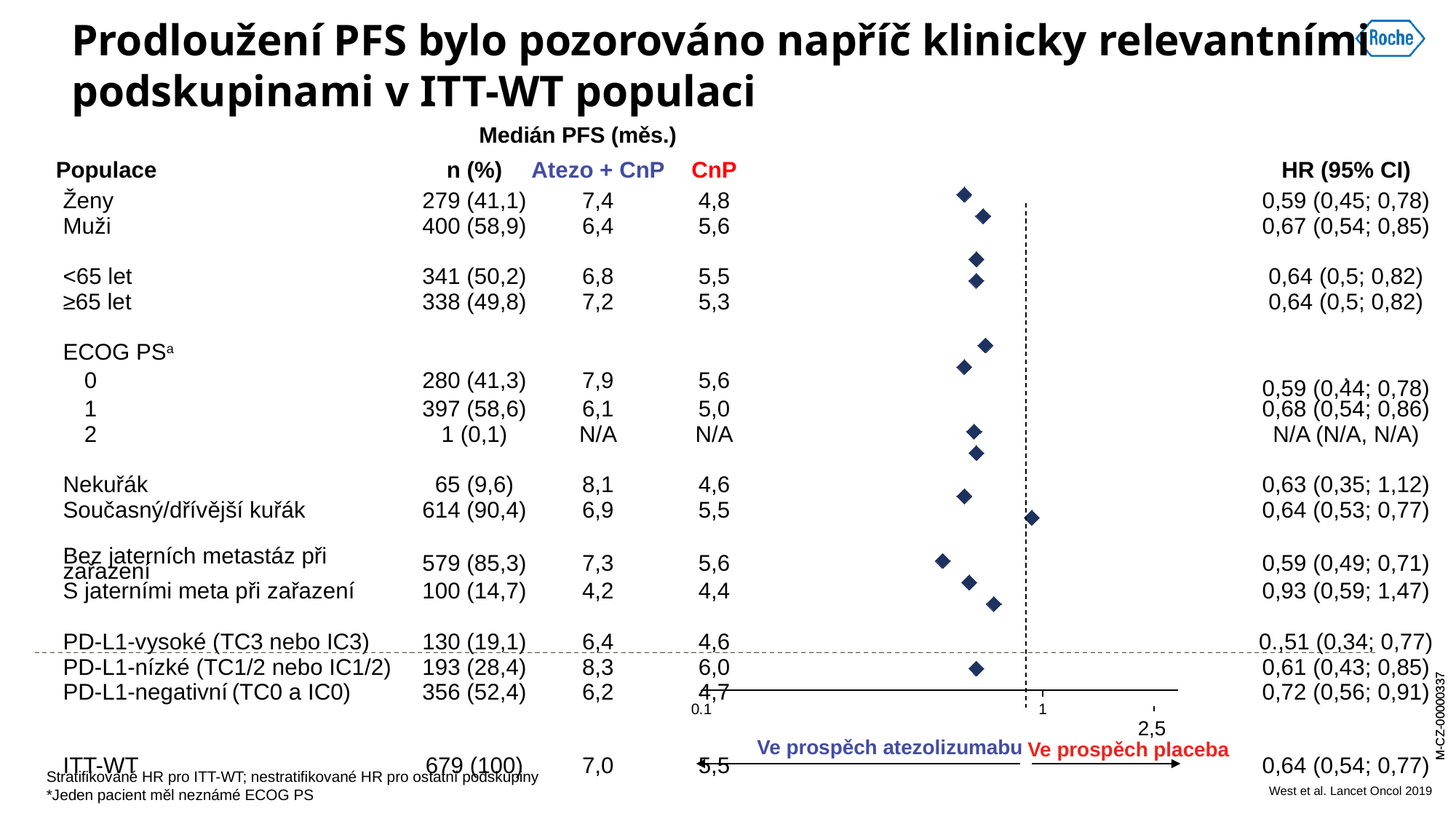
Is the HR point estimate for S jaterními meta při zařazení greater or less than 1? less What is the difference between the HR point estimate for ITT-WT and for Ženy? 0,05 What value does the dashed vertical reference line mark on the x axis? 1 What is the HR (95% CI) for the Ženy subgroup? 0,59 (0,45; 0,78) Which has the larger HR point estimate, PD-L1-nízké (TC1/2 nebo IC1/2) or PD-L1-negativní (TC0 a IC0)? PD-L1-negativní (TC0 a IC0) What is the label on the left side of the x axis arrow? Ve prospěch atezolizumabu Which subgroup has the highest HR point estimate? S jaterními meta při zařazení Which subgroup has the lowest HR point estimate? PD-L1-vysoké (TC3 nebo IC3) What is the HR (95% CI) for the ITT-WT population? 0,64 (0,54; 0,77) What is the HR (95% CI) for the S jaterními meta při zařazení subgroup? 0,93 (0,59; 1,47) What is the median PFS (months) for Atezo + CnP in the Nekuřák subgroup? 8,1 What kind of chart is shown on the slide? forest plot